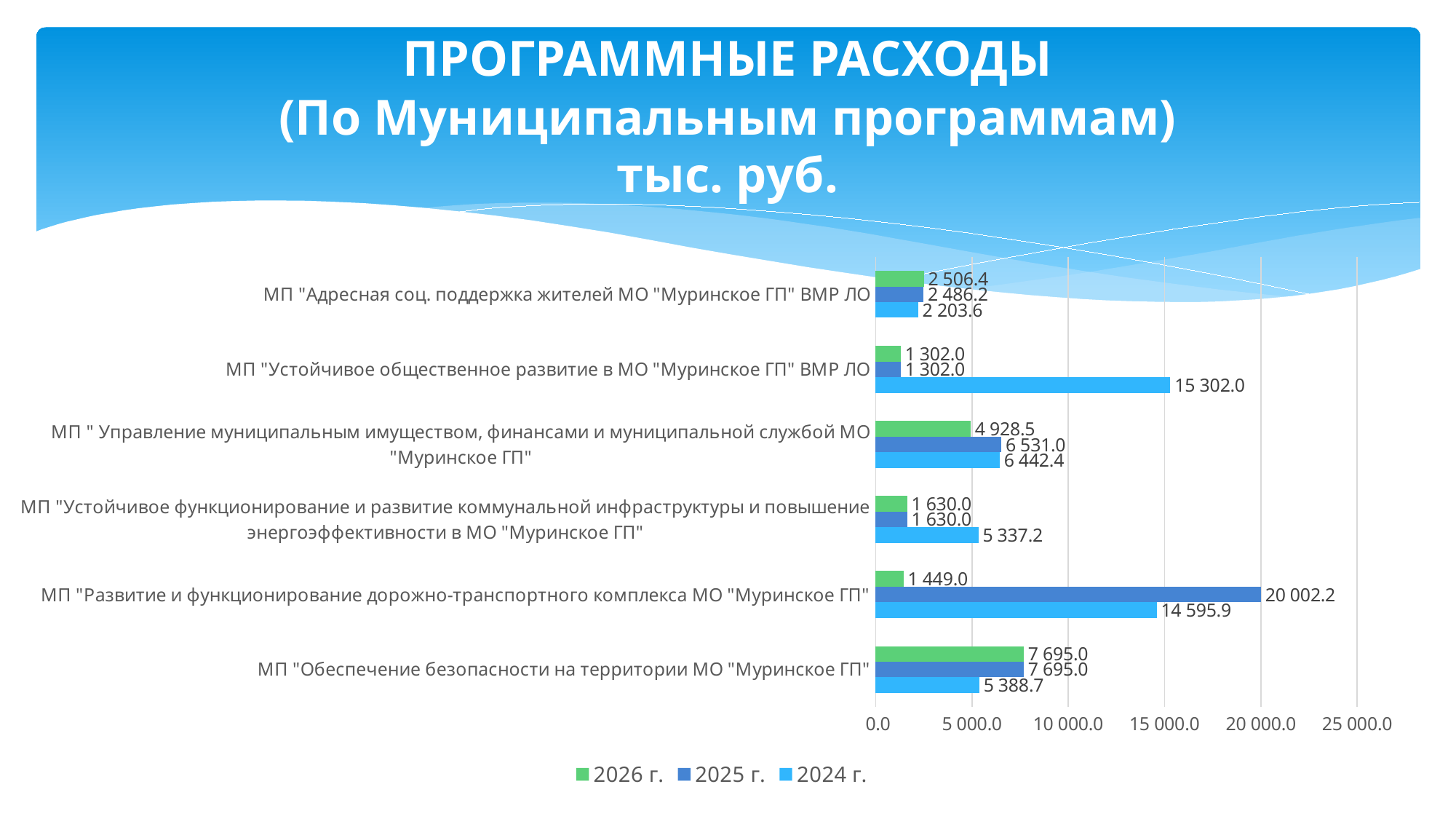
Which program has the lowest 2024 г. value? МП "Адресная соц. поддержка жителей МО "Муринское ГП" ВМР ЛО" What type of chart is shown on the slide? Bar chart What is the 2024 г. value for МП "Устойчивое общественное развитие в МО "Муринское ГП" ВМР ЛО"? 15 302.0 What is the 2025 г. value for МП "Развитие и функционирование дорожно-транспортного комплекса МО "Муринское ГП"? 20 002.2 What is the difference between the 2025 г. and 2024 г. values for МП "Развитие и функционирование дорожно-транспортного комплекса МО "Муринское ГП"? 5 406.3 How many series does the legend list? 3 How many municipal programs (categories) are shown on the chart? 6 Which program has the highest 2026 г. value? МП "Обеспечение безопасности на территории МО "Муринское ГП" What is the 2026 г. value for МП "Обеспечение безопасности на территории МО "Муринское ГП"? 7 695.0 What unit of measurement is stated in the chart title? тыс. руб. What is the difference between the 2024 г. and 2026 г. values for МП "Устойчивое общественное развитие в МО "Муринское ГП" ВМР ЛО"? 14 000.0 For МП "Управление муниципальным имуществом, финансами и муниципальной службой МО "Муринское ГП", which is larger: the 2025 г. value or the 2026 г. value? 2025 г.